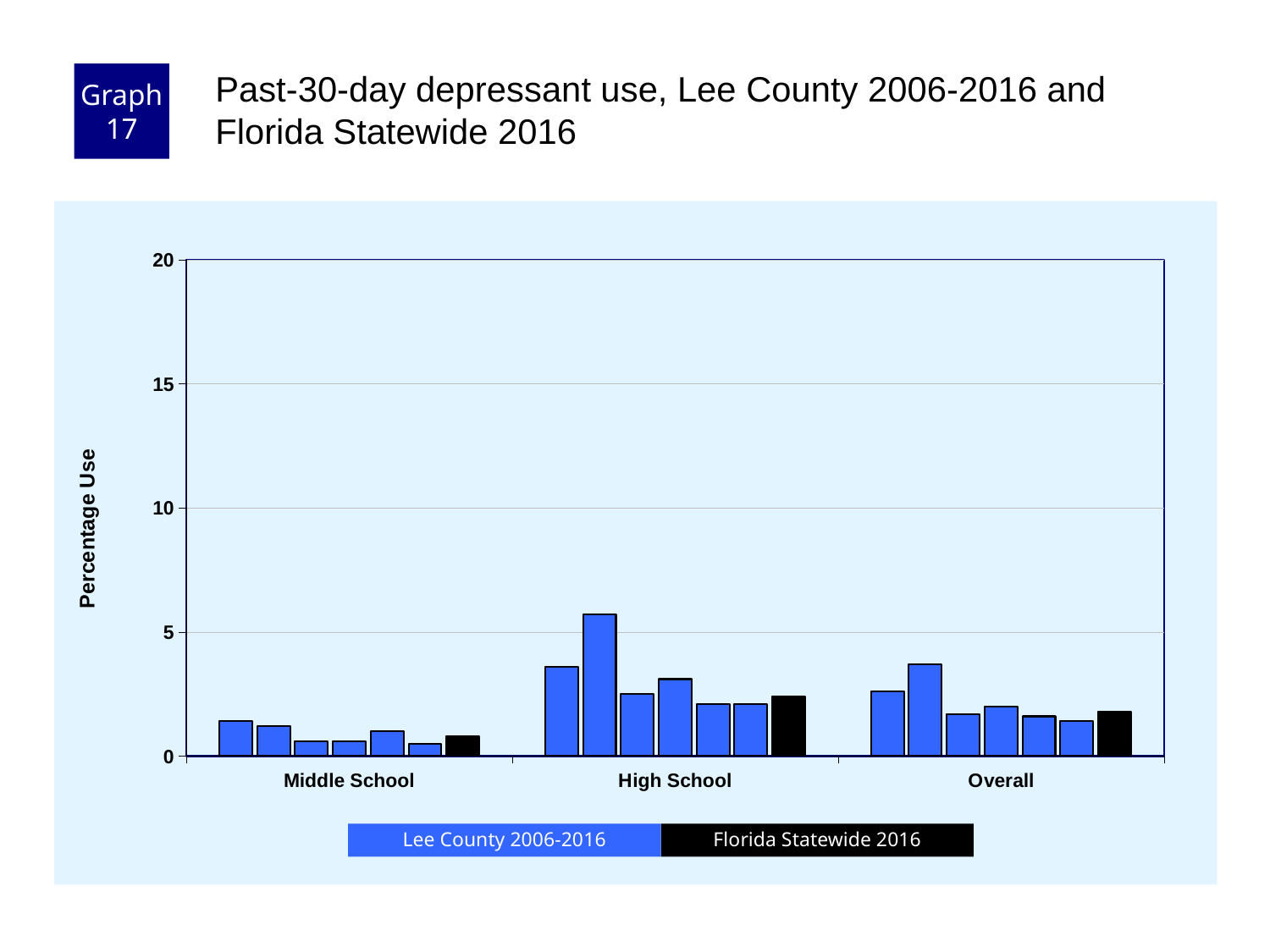
Is the Florida Statewide 2016 value for Middle School greater or less than 5? less What is the label of the y axis? Percentage Use How many series does the legend list? 2 Which is larger, the Florida Statewide 2016 value for High School or for Middle School? High School Which colour represents Florida Statewide 2016 in the legend? black Is the tallest bar in the High School group greater or less than 5? greater How many categories are shown on the x axis? 3 Which category has the lowest Florida Statewide 2016 value? Middle School Is the Florida Statewide 2016 value for Overall greater or less than 5? less Which category contains the tallest bar on the chart? High School What kind of chart is shown on the slide? bar chart How many bars are plotted in the Overall category? 7